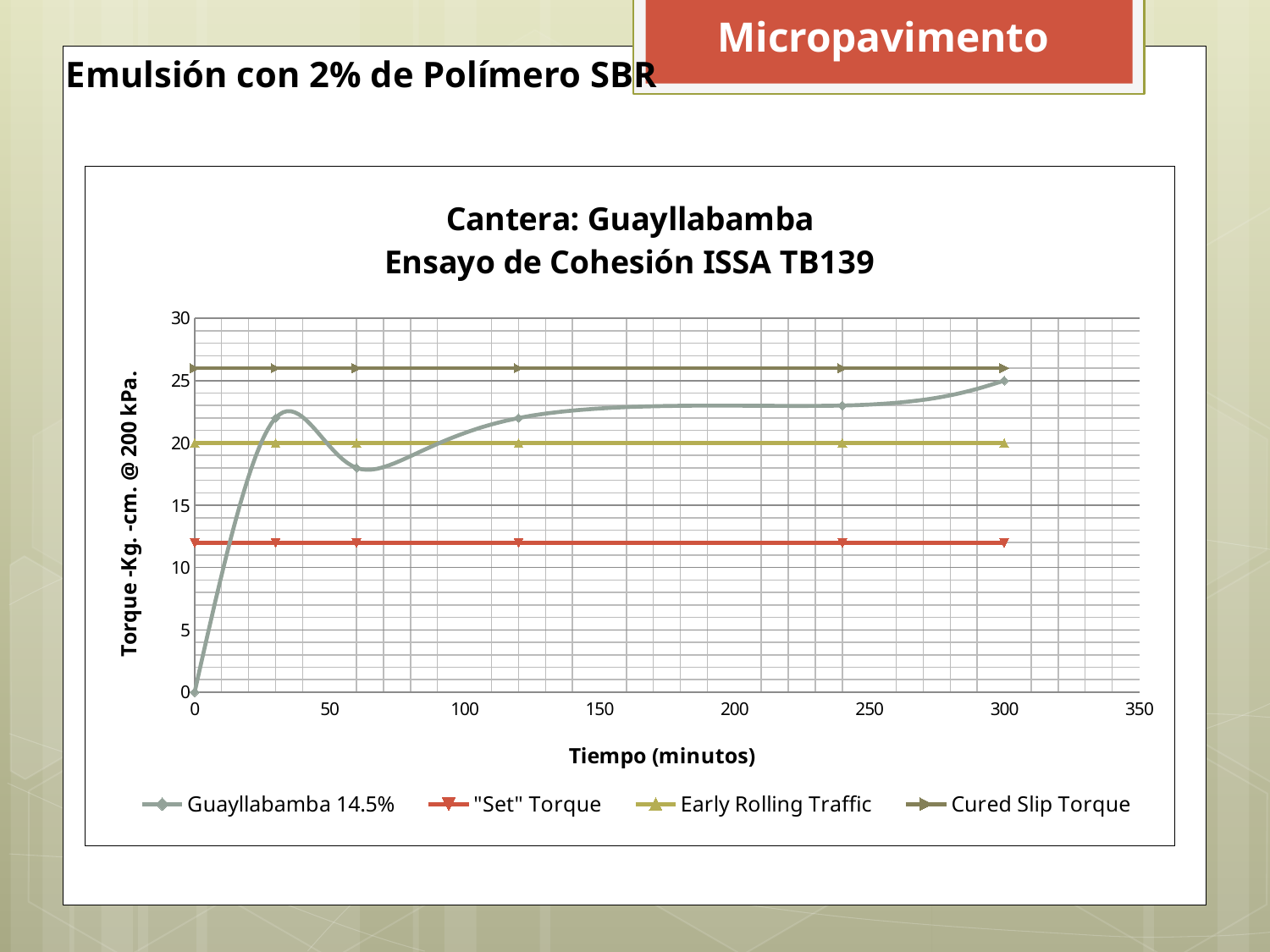
Is the value of the Cured Slip Torque line greater or less than 25? greater What is the value of Guayllabamba 14.5% at 0 minutes? 0 What is the title of the x axis? Tiempo (minutos) What kind of chart is shown on the slide? line chart What is the value of the Early Rolling Traffic line? 20 Which of the three horizontal reference lines has the highest value? Cured Slip Torque Does the Guayllabamba 14.5% line rise or fall between 120 and 300 minutes? rises How many series does the legend list? 4 Is the value of Guayllabamba 14.5% at 60 minutes greater or less than 20? less Is the value of the "Set" Torque line greater or less than 15? less What is the value of Guayllabamba 14.5% at 300 minutes? 25 At 120 minutes, which is higher: Guayllabamba 14.5% or Early Rolling Traffic? Guayllabamba 14.5%